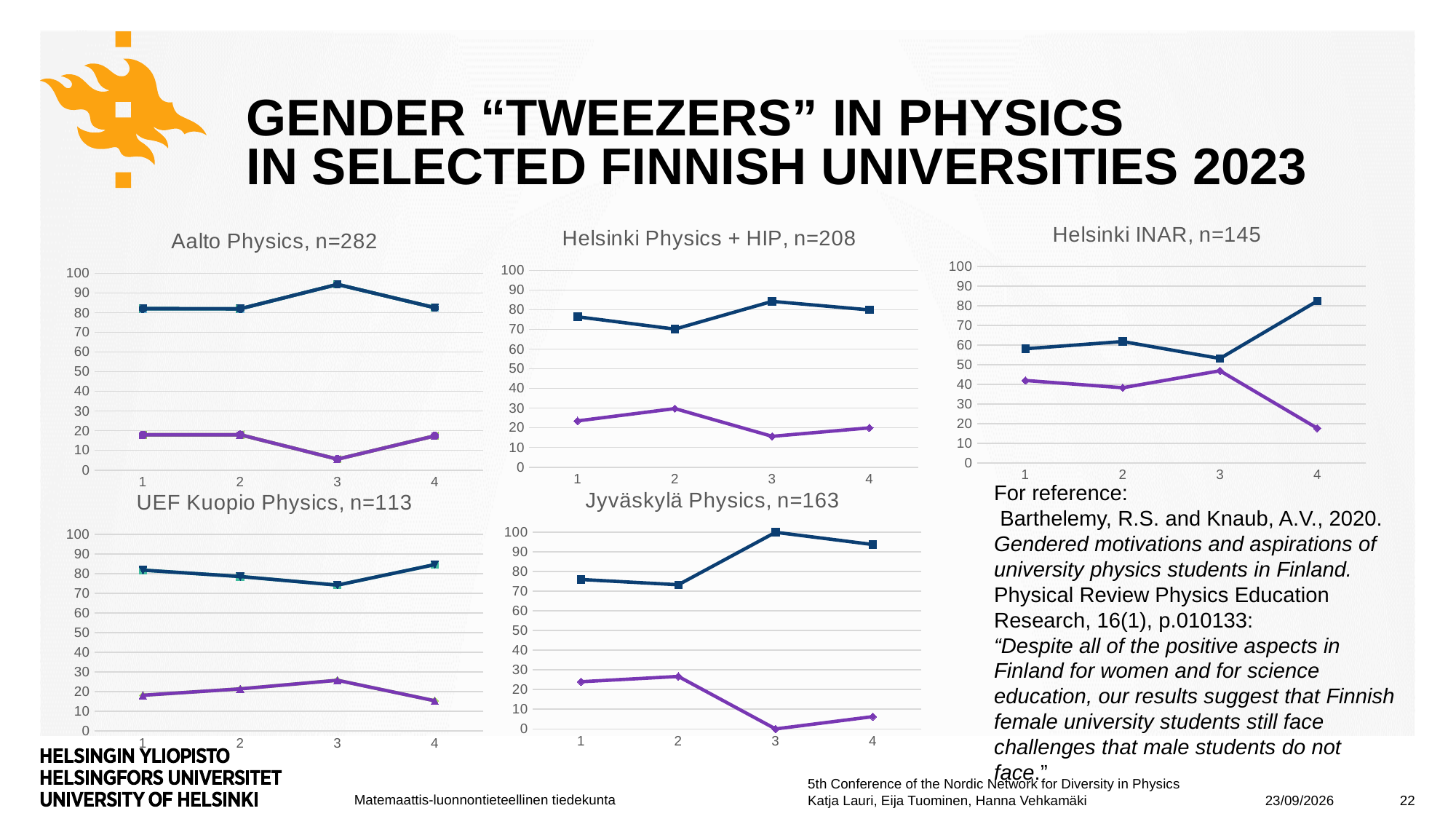
In the Jyväskylä Physics, n=163 chart, is the value of the upper (dark blue) line at point 3 greater or less than 90? greater In the Aalto Physics, n=282 chart, at which x-axis point does the lower (purple) line reach its lowest value? 3 In the Helsinki INAR, n=145 chart, is the value of the lower (purple) line at point 4 greater or less than 30? less In the Helsinki INAR, n=145 chart, at which x-axis point does the upper (dark blue) line reach its highest value? 4 In the Aalto Physics, n=282 chart, how many points are plotted along the x axis for each line? 4 In the Aalto Physics, n=282 chart, at which x-axis point does the upper (dark blue) line reach its highest value? 3 What kind of chart is the Aalto Physics, n=282 chart? line chart How many charts are shown on the slide? 5 In the Helsinki INAR, n=145 chart, does the lower (purple) line rise or fall from point 3 to point 4? fall In the Helsinki Physics + HIP, n=208 chart, which line has the larger value at point 1, the dark blue line or the purple line? the dark blue line In the UEF Kuopio Physics, n=113 chart, is the value of the upper (dark blue) line at point 3 greater or less than 80? less